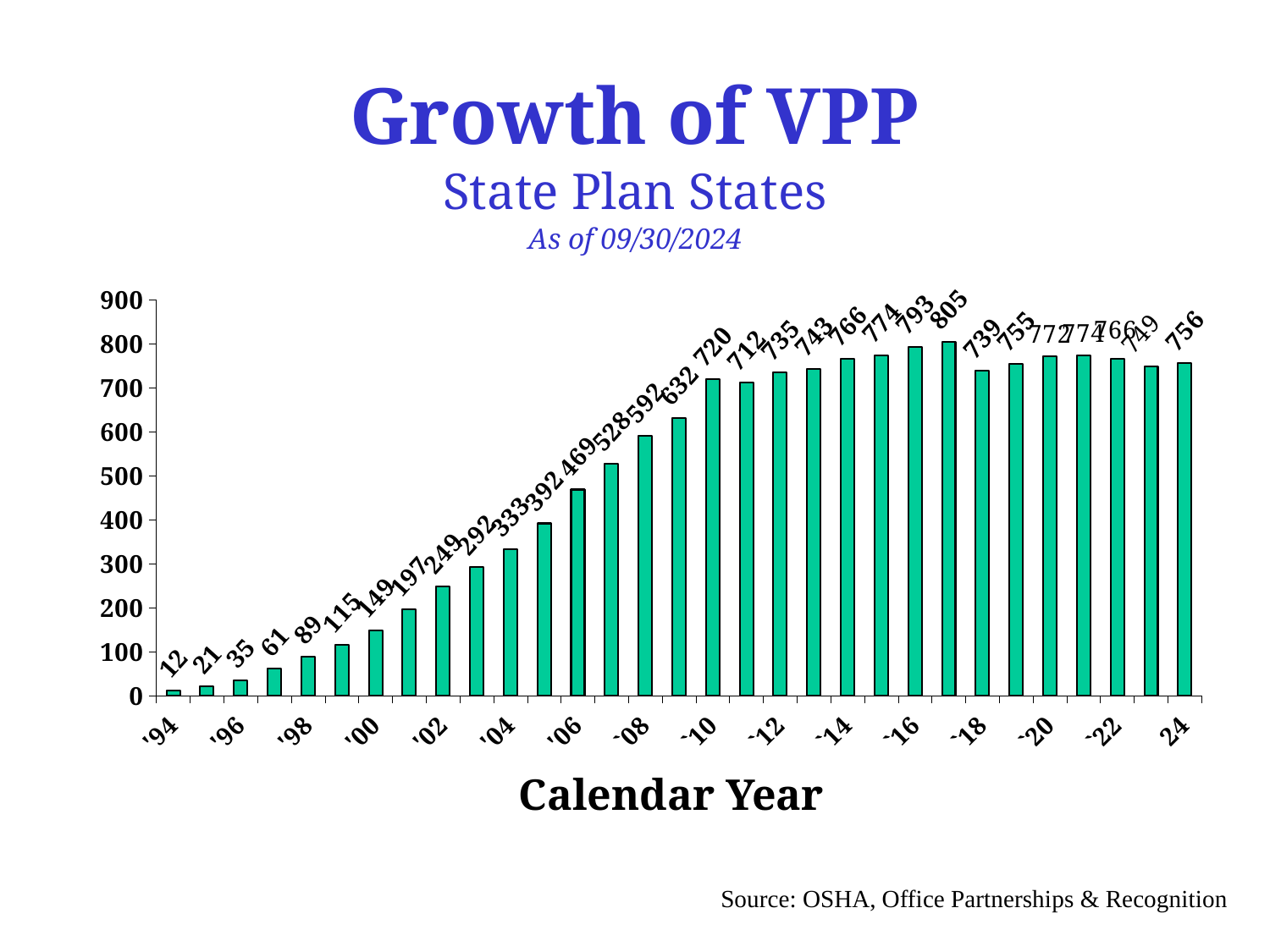
What type of chart is shown on the slide? bar chart What is the value for '10? 720 Is the value for '06 greater or less than 400? greater Which is larger, the value for '17 or the value for '18? '17 What is the value for '00? 149 What is the x-axis title of the chart? Calendar Year What is the value for '94? 12 What is the value for '24? 756 Which year has the highest value? '17 What is the highest value shown on the chart? 805 What is the difference between the values for '10 and '00? 571 Which year has the lowest value? '94